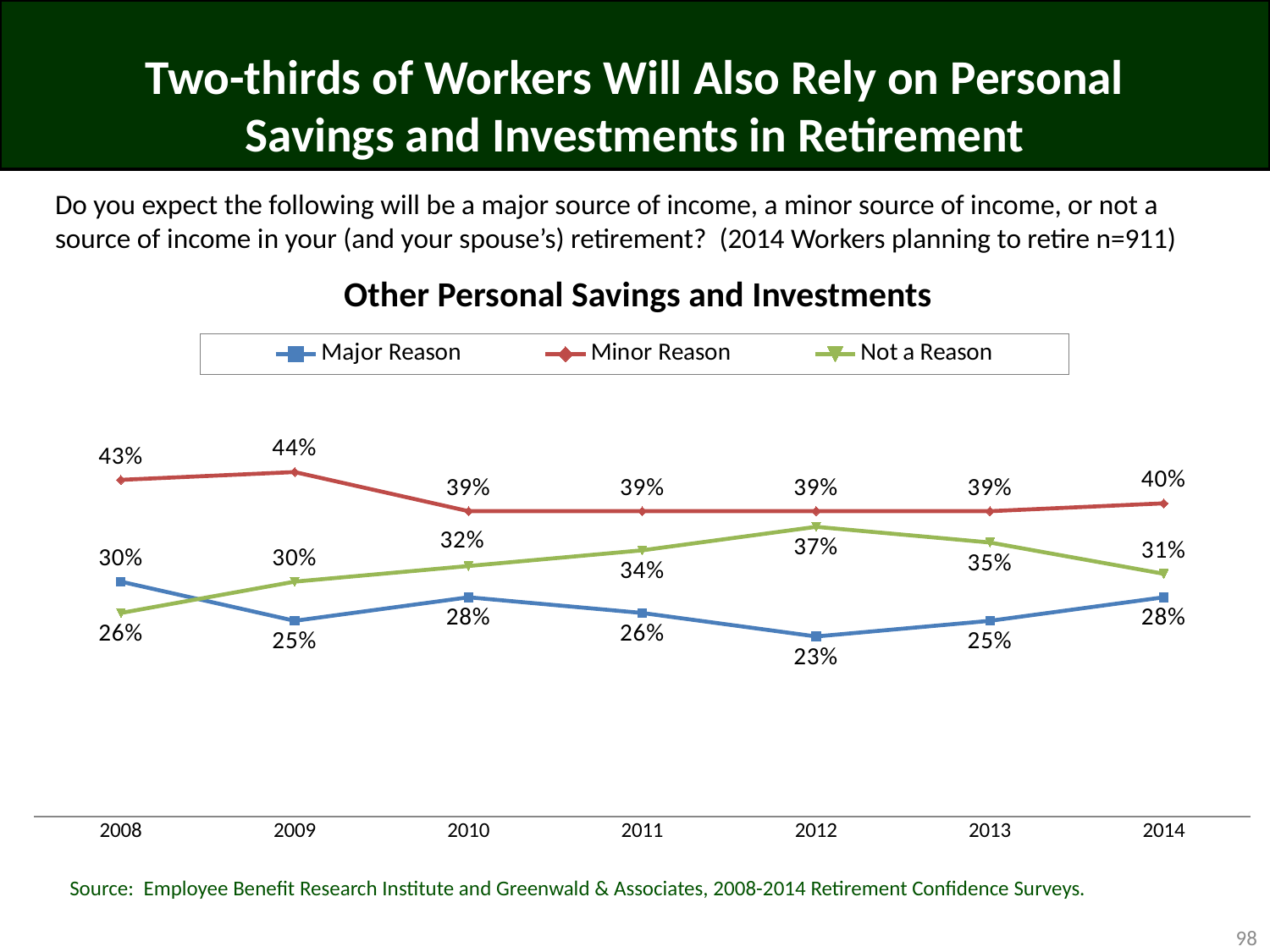
What is the value for Major Reason in 2012? 23% In which year is the Not a Reason value highest? 2012 Which is larger in 2008, Major Reason or Not a Reason? Major Reason What type of chart is shown on the slide? line chart What is the title of the chart? Other Personal Savings and Investments How many series does the legend list? 3 What is the value for Minor Reason in 2009? 44% How many years are plotted along the x axis? 7 Does the Not a Reason series rise or fall from 2008 to 2012? rise What is the difference between the Minor Reason and Major Reason values in 2014? 12% What is the value for Not a Reason in 2011? 34% In which year is the Major Reason value lowest? 2012